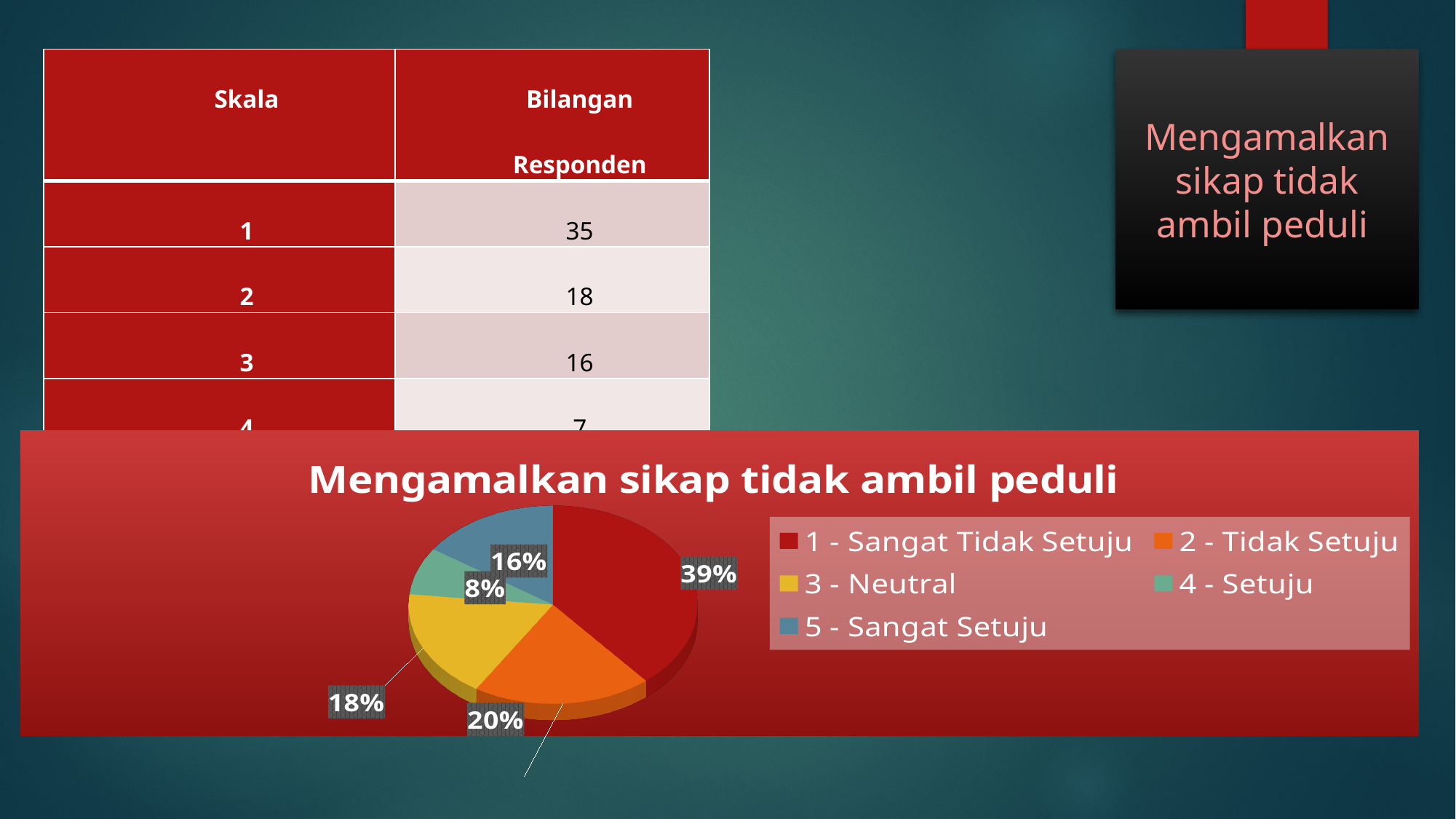
Which category has the smallest slice of the pie? 4 - Setuju How many slices does the pie chart have? 5 What share of the pie is labelled for 2 - Tidak Setuju? 20% What is the title of the chart? Mengamalkan sikap tidak ambil peduli What share of the pie is labelled for 4 - Setuju? 8% What share of the pie is labelled for 5 - Sangat Setuju? 16% What kind of chart is shown on the slide? pie chart Which category has the largest slice of the pie? 1 - Sangat Tidak Setuju What is the difference in percentage points between the 1 - Sangat Tidak Setuju slice and the 2 - Tidak Setuju slice? 19% How many series does the chart legend list? 5